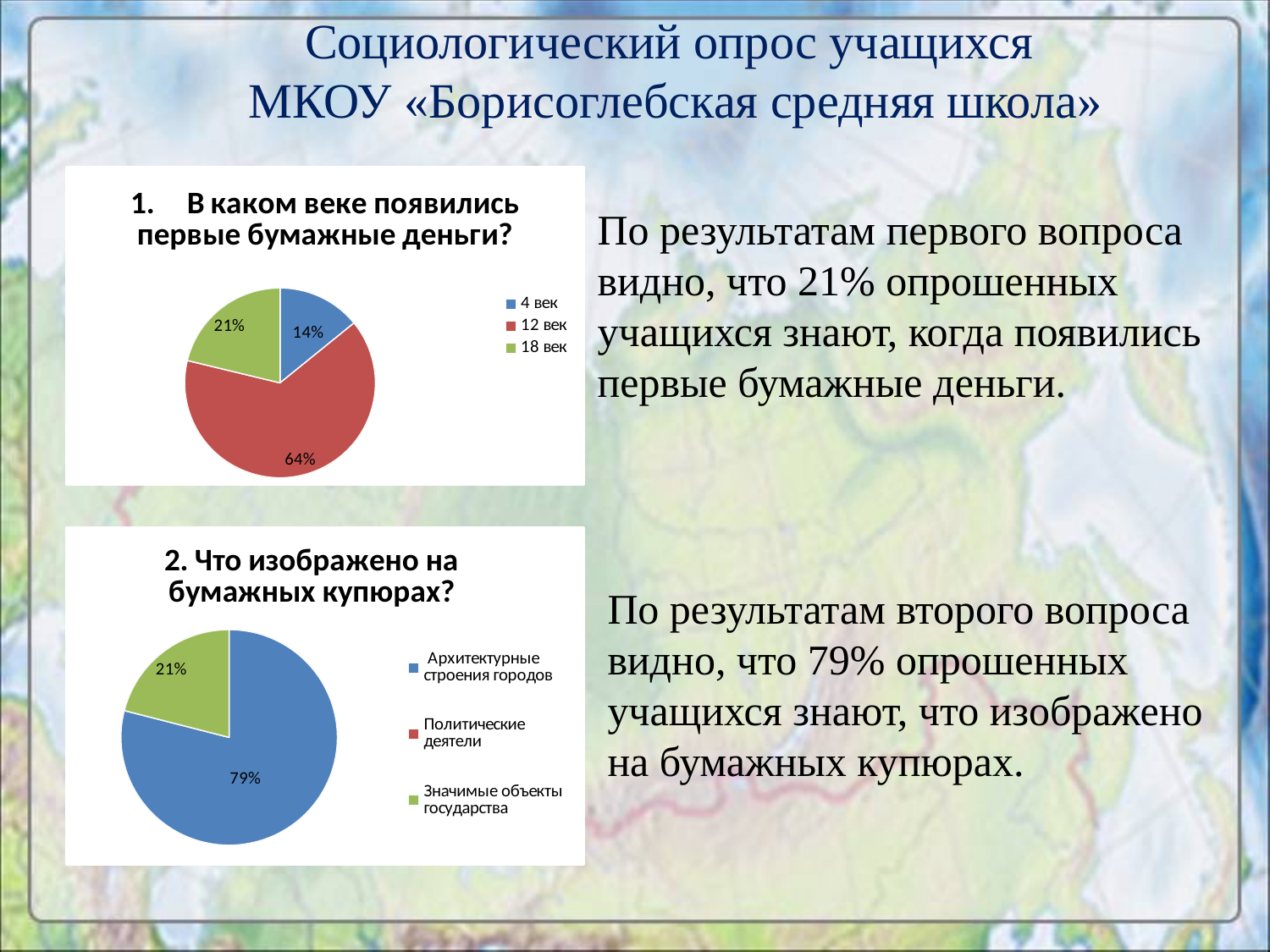
In the bottom chart "Что изображено на бумажных купюрах?", what share of respondents chose "Архитектурные строения городов"? 79% In the bottom chart "Что изображено на бумажных купюрах?", which is larger: "Архитектурные строения городов" or "Значимые объекты государства"? Архитектурные строения городов In the top chart "В каком веке появились первые бумажные деньги?", what is the difference in percentage points between "12 век" and "18 век"? 43 In the top chart "В каком веке появились первые бумажные деньги?", how many entries does the legend list? 3 In the bottom chart "Что изображено на бумажных купюрах?", what colour is the slice for "Архитектурные строения городов"? blue In the top chart "В каком веке появились первые бумажные деньги?", what share of respondents chose "18 век"? 21% In the top chart "В каком веке появились первые бумажные деньги?", what share of respondents chose "12 век"? 64% In the bottom chart "Что изображено на бумажных купюрах?", what share of respondents chose "Значимые объекты государства"? 21% In the top chart "В каком веке появились первые бумажные деньги?", which answer has the smallest slice? 4 век What type of chart is the top chart "В каком веке появились первые бумажные деньги?"? pie chart In the top chart "В каком веке появились первые бумажные деньги?", which answer has the largest slice? 12 век In the top chart "В каком веке появились первые бумажные деньги?", what share of respondents chose "4 век"? 14%